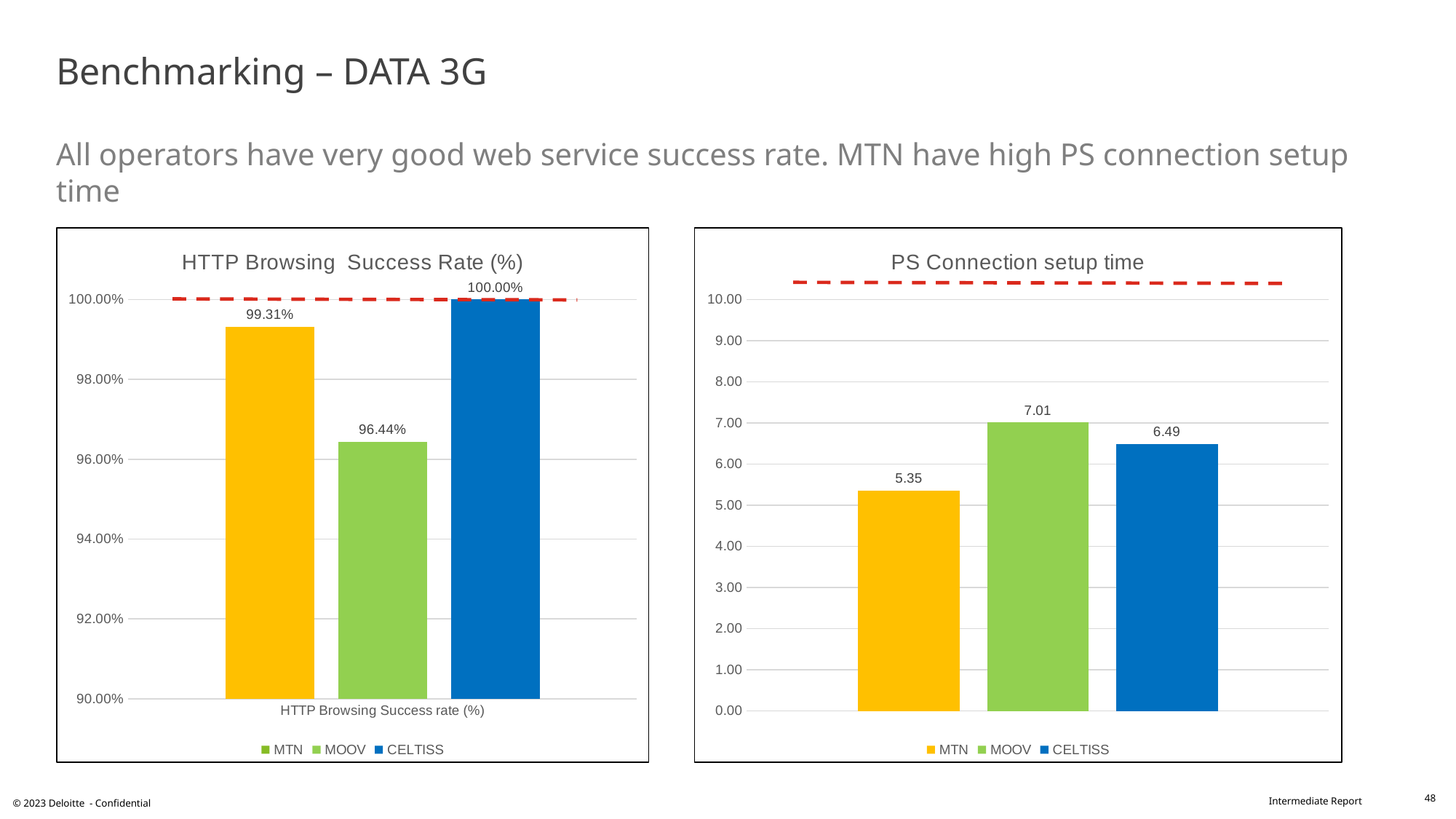
In the PS Connection setup time chart, is the value for CELTISS larger or smaller than the value for MOOV? smaller In the HTTP Browsing Success Rate (%) chart, which operator has the lowest success rate? MOOV In the HTTP Browsing Success Rate (%) chart, what is the difference between the CELTISS and MTN values? 0.69% In the HTTP Browsing Success Rate (%) chart, what is the value for MOOV? 96.44% In the PS Connection setup time chart, what is the value for CELTISS? 6.49 In the HTTP Browsing Success Rate (%) chart, which operator has the highest success rate? CELTISS In the PS Connection setup time chart, which operator has the lowest setup time? MTN What kind of chart is the PS Connection setup time chart? Bar chart In the PS Connection setup time chart, which operator has the highest setup time? MOOV In the PS Connection setup time chart, what is the value for MTN? 5.35 In the PS Connection setup time chart, what is the difference between the MOOV and MTN values? 1.66 In the HTTP Browsing Success Rate (%) chart, how many series does the legend list? 3